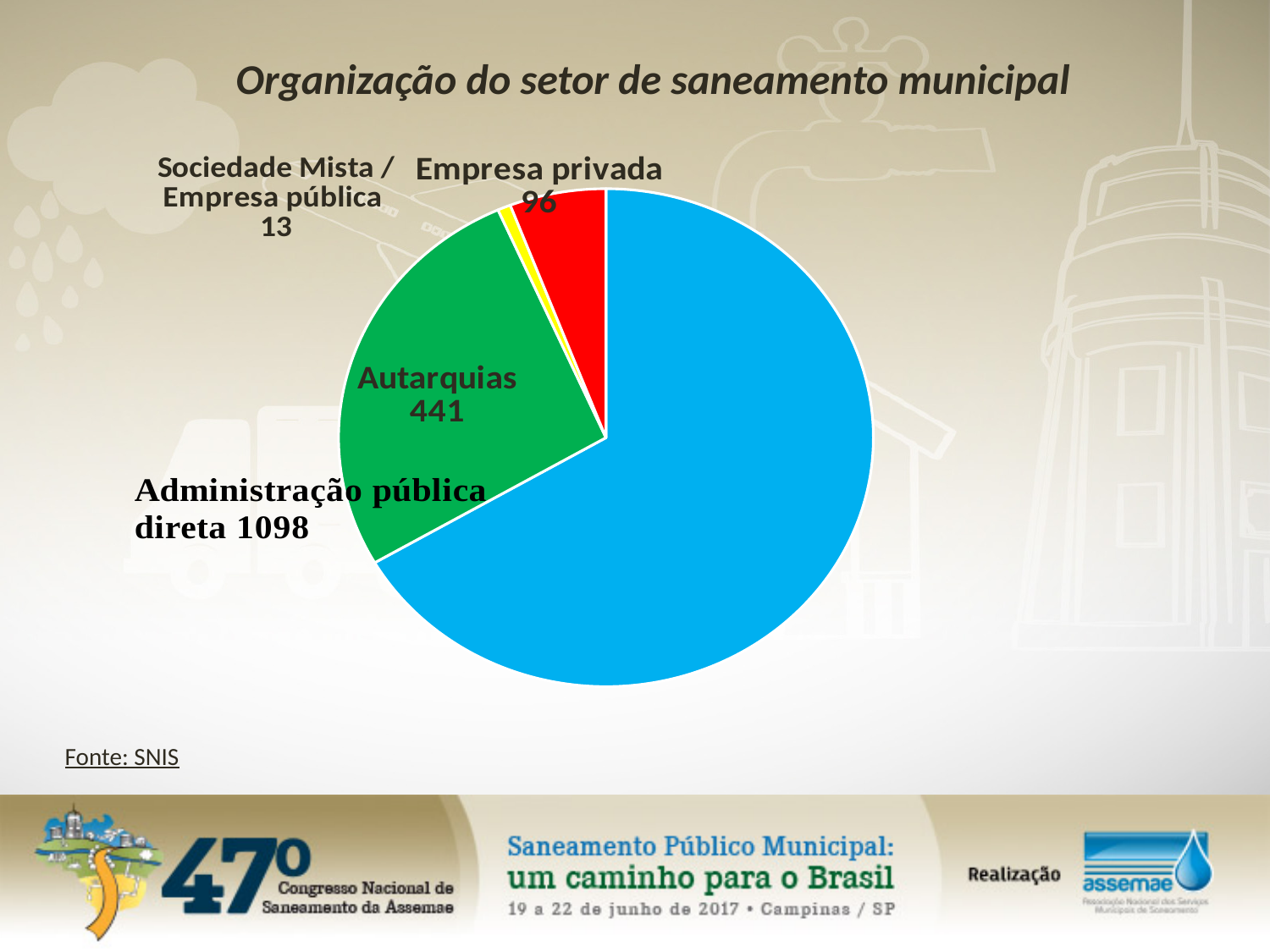
What is the difference between the values for Empresa privada and Sociedade Mista / Empresa pública? 83 How many categories (slices) does the pie chart have? 4 What type of chart is shown on the slide? Pie chart What is the difference between the values for Administração pública direta and Autarquias? 657 Which is larger, the value for Autarquias or the value for Empresa privada? Autarquias What is the value for Autarquias? 441 What is the value for Empresa privada? 96 What is the title of the chart? Organização do setor de saneamento municipal Which category has the smallest slice of the pie? Sociedade Mista / Empresa pública What is the value for Administração pública direta? 1098 What is the value for Sociedade Mista / Empresa pública? 13 Which category has the largest slice of the pie? Administração pública direta